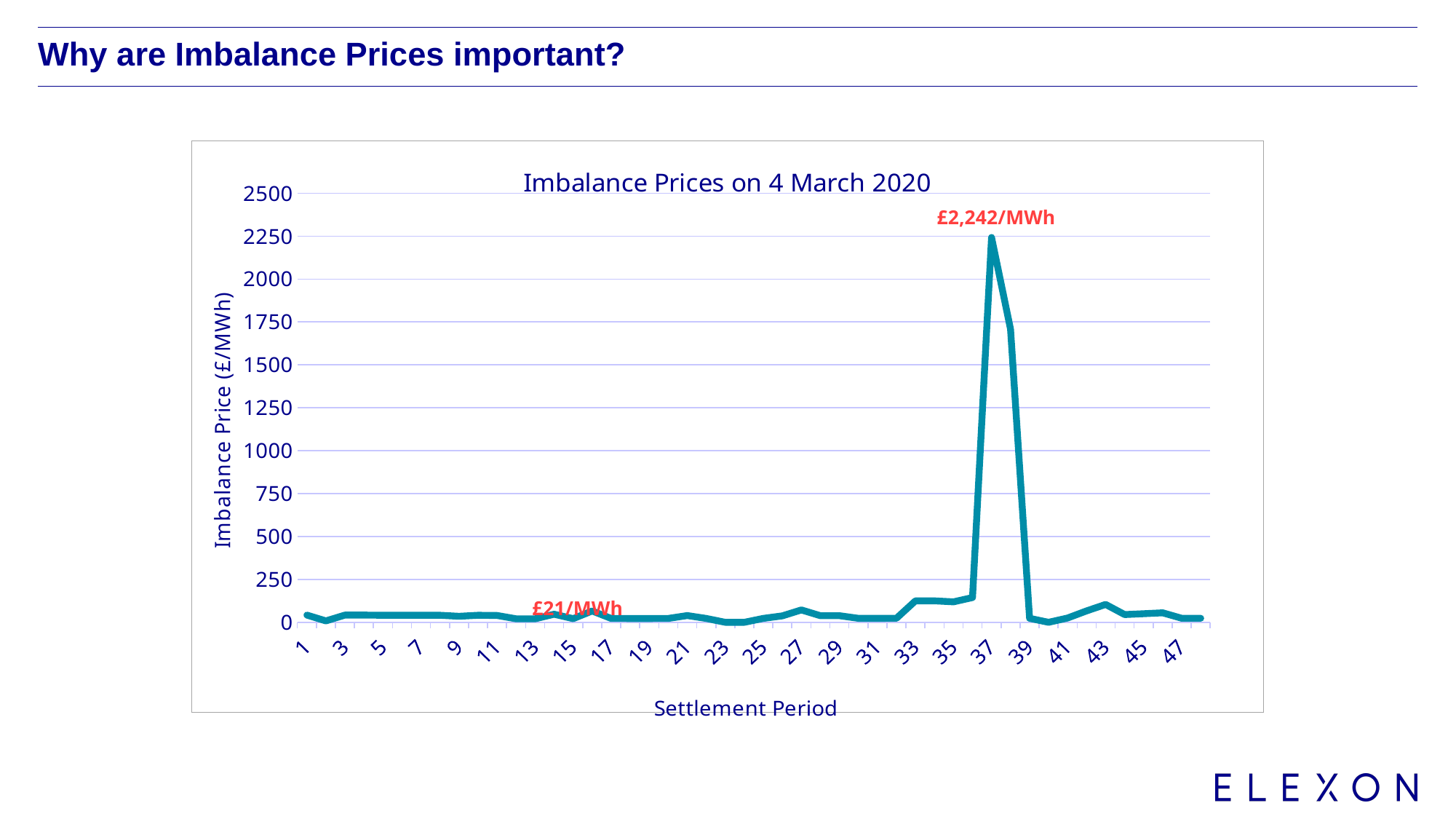
Does the imbalance price rise or fall between settlement period 37 and settlement period 39? fall At which settlement period does the imbalance price reach its peak? 37 What is the title of the chart? Imbalance Prices on 4 March 2020 Which has the higher imbalance price, settlement period 37 or settlement period 1? settlement period 37 What is the lower imbalance price labelled on the chart? £21/MWh Is the imbalance price at settlement period 38 greater or less than 1500? greater Is the imbalance price at settlement period 25 greater or less than 250? less What is the label on the vertical axis of the chart? Imbalance Price (£/MWh) What is the difference between the two labelled prices, £2,242/MWh and £21/MWh? £2,221/MWh What is the highest imbalance price labelled on the chart? £2,242/MWh Is the imbalance price at settlement period 36 greater or less than 250? less What kind of chart is shown on the slide? line chart